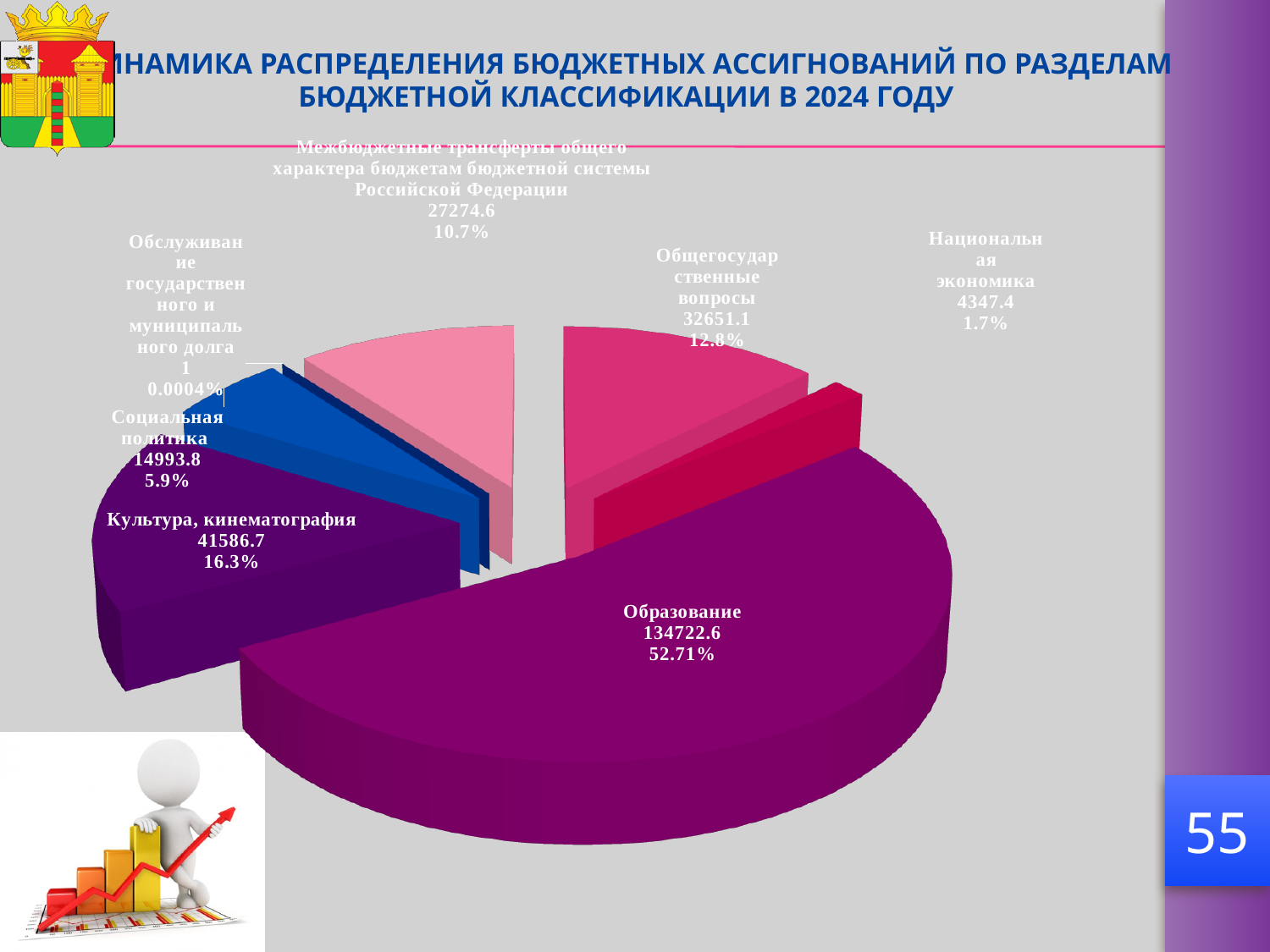
Which is larger: Культура, кинематография or Общегосударственные вопросы? Культура, кинематография What share of the pie does Социальная политика represent? 5.9% Which category has the smallest slice of the pie? Обслуживание государственного и муниципального долга How many categories are shown in the pie chart? 7 What share of the pie does Образование represent? 52.71% What is the value for Образование? 134722.6 What is the value for Культура, кинематография? 41586.7 Which category has the largest slice of the pie? Образование What share of the pie does Национальная экономика represent? 1.7% What is the difference between the values for Общегосударственные вопросы and Межбюджетные трансферты общего характера бюджетам бюджетной системы Российской Федерации? 5376.5 What type of chart is shown on the slide? pie chart What is the value for Общегосударственные вопросы? 32651.1